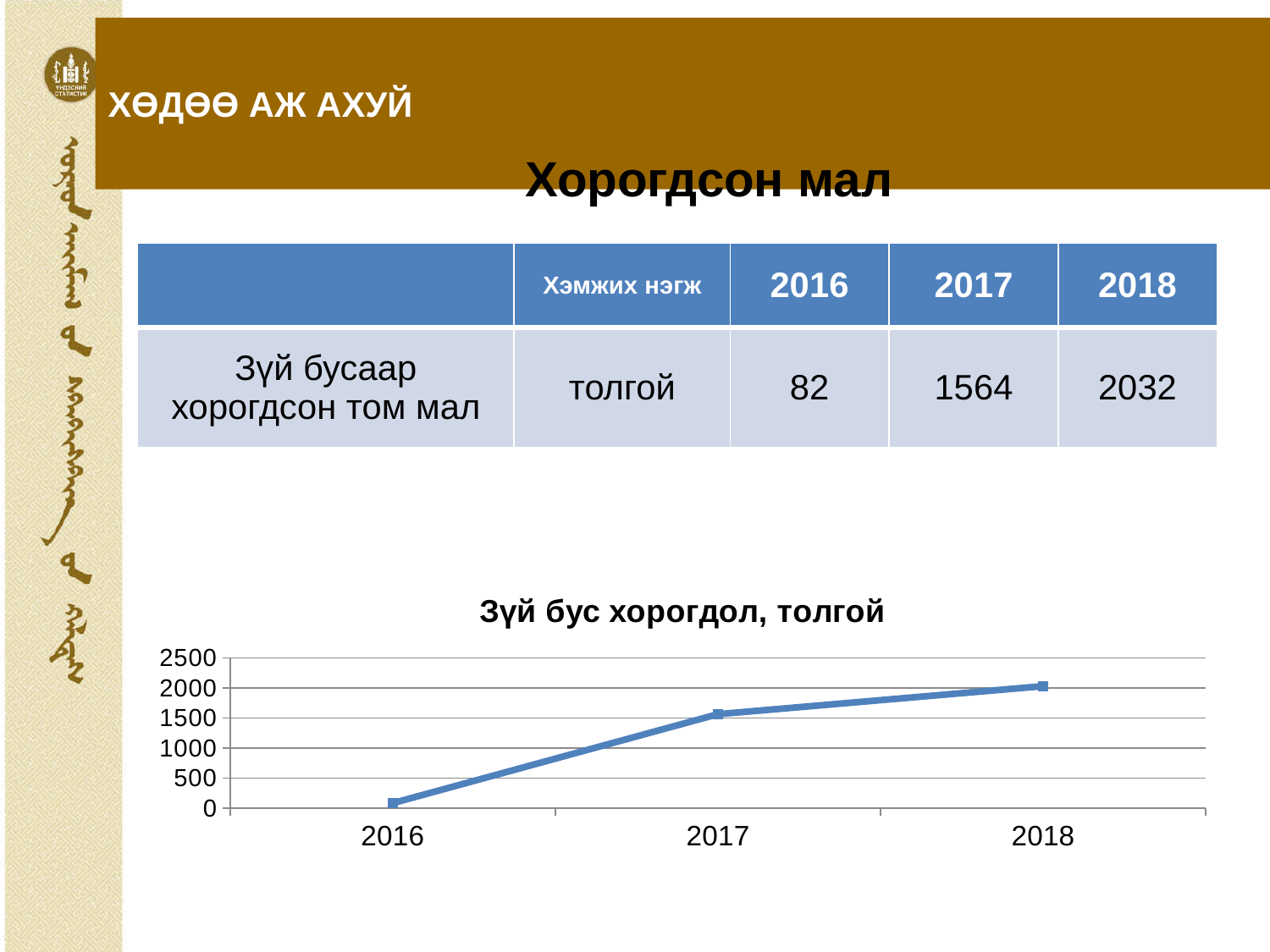
According to the table on the slide, what is the value for 2017? 1564 Which year has the highest value in the chart? 2018 Is the value for 2017 in the chart greater or less than 1500? greater Using the values in the table, what is the difference between 2018 and 2017? 468 What is the title of the chart? Зүй бус хорогдол, толгой According to the table on the slide, what is the value for 2018? 2032 How many years are plotted on the x axis of the chart? 3 What type of chart is shown on the slide? line chart Is the value for 2016 in the chart greater or less than 500? less Which year has the lowest value in the chart? 2016 Is the value for 2018 in the chart greater or less than 2000? greater Do the values in the chart rise or fall from 2016 to 2018? rise